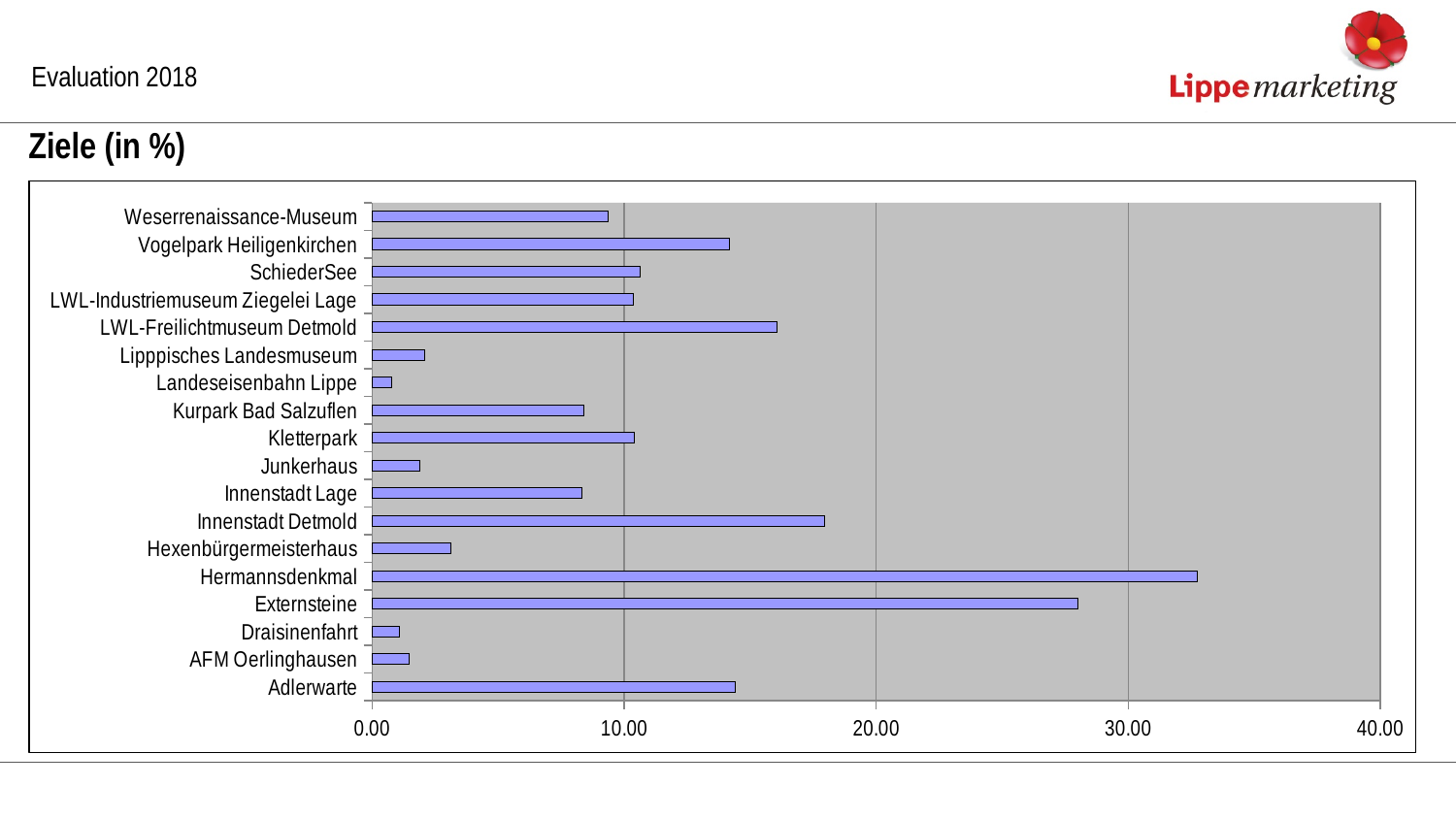
Is the value for Innenstadt Detmold greater or less than 20.00? less Which has the larger value, Hermannsdenkmal or Externsteine? Hermannsdenkmal Which has the larger value, Innenstadt Detmold or Innenstadt Lage? Innenstadt Detmold Is the value for Adlerwarte greater or less than 10.00? greater Is the value for Weserrenaissance-Museum greater or less than 10.00? less What is the title of the chart? Ziele (in %) Which category has the highest value? Hermannsdenkmal What kind of chart is shown on the slide? bar chart How many categories are plotted in the chart? 18